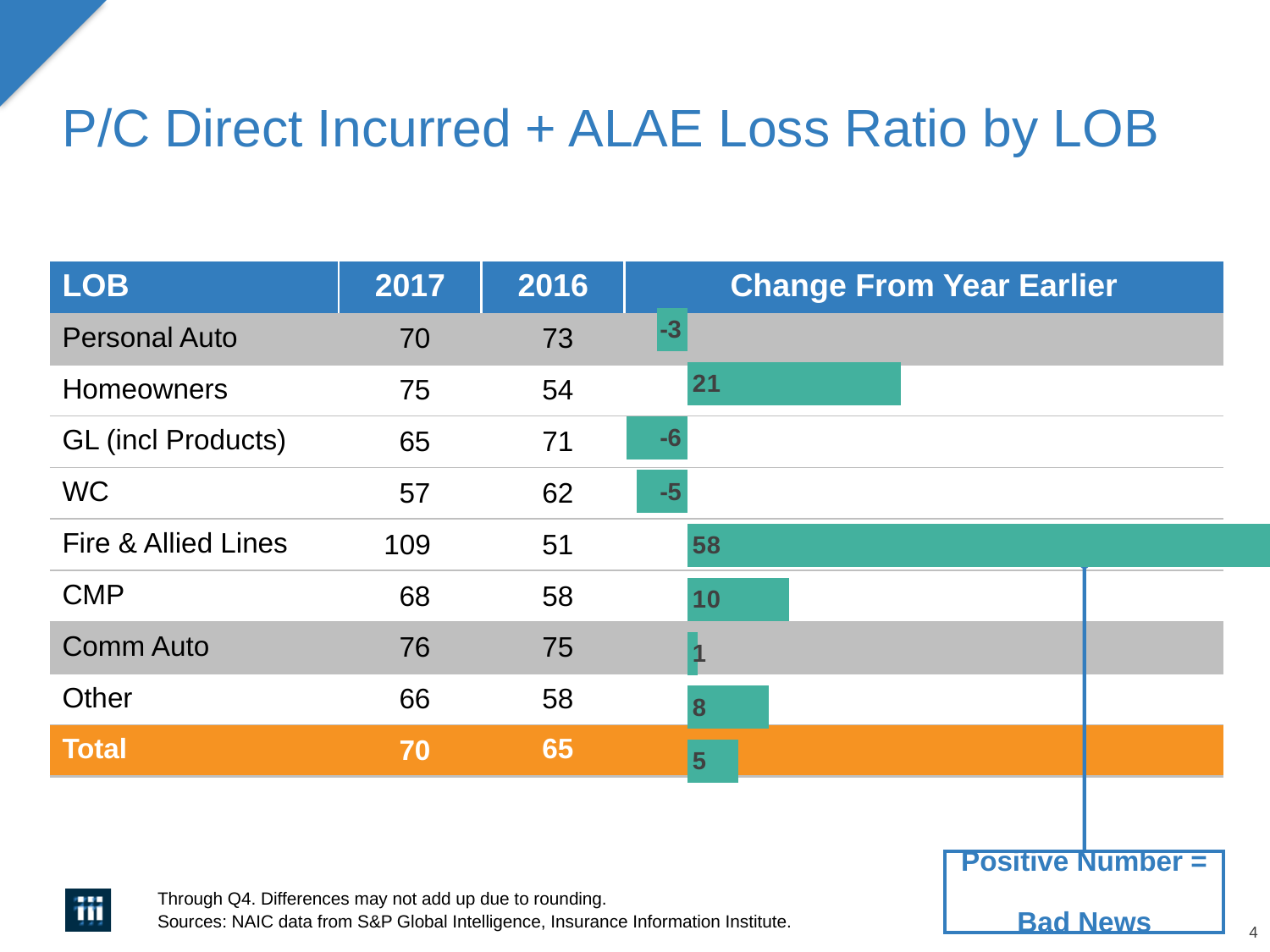
What is the change from year earlier shown for the Total row? 5 How many lines of business show a negative change from year earlier? 3 What is the change from year earlier shown for Fire & Allied Lines? 58 Which line of business has the lowest (most negative) change from year earlier? GL (incl Products) How many bars are plotted in the Change From Year Earlier chart, including the Total row? 9 Which has a larger change from year earlier, CMP or Other? CMP According to the note on the slide, what does a positive number indicate? Bad News What is the difference between the change from year earlier for Homeowners and for CMP? 11 Which line of business has the largest change from year earlier? Fire & Allied Lines What is the change from year earlier shown for GL (incl Products)? -6 What is the change from year earlier shown for Homeowners? 21 What kind of chart is used to show the Change From Year Earlier? Bar chart